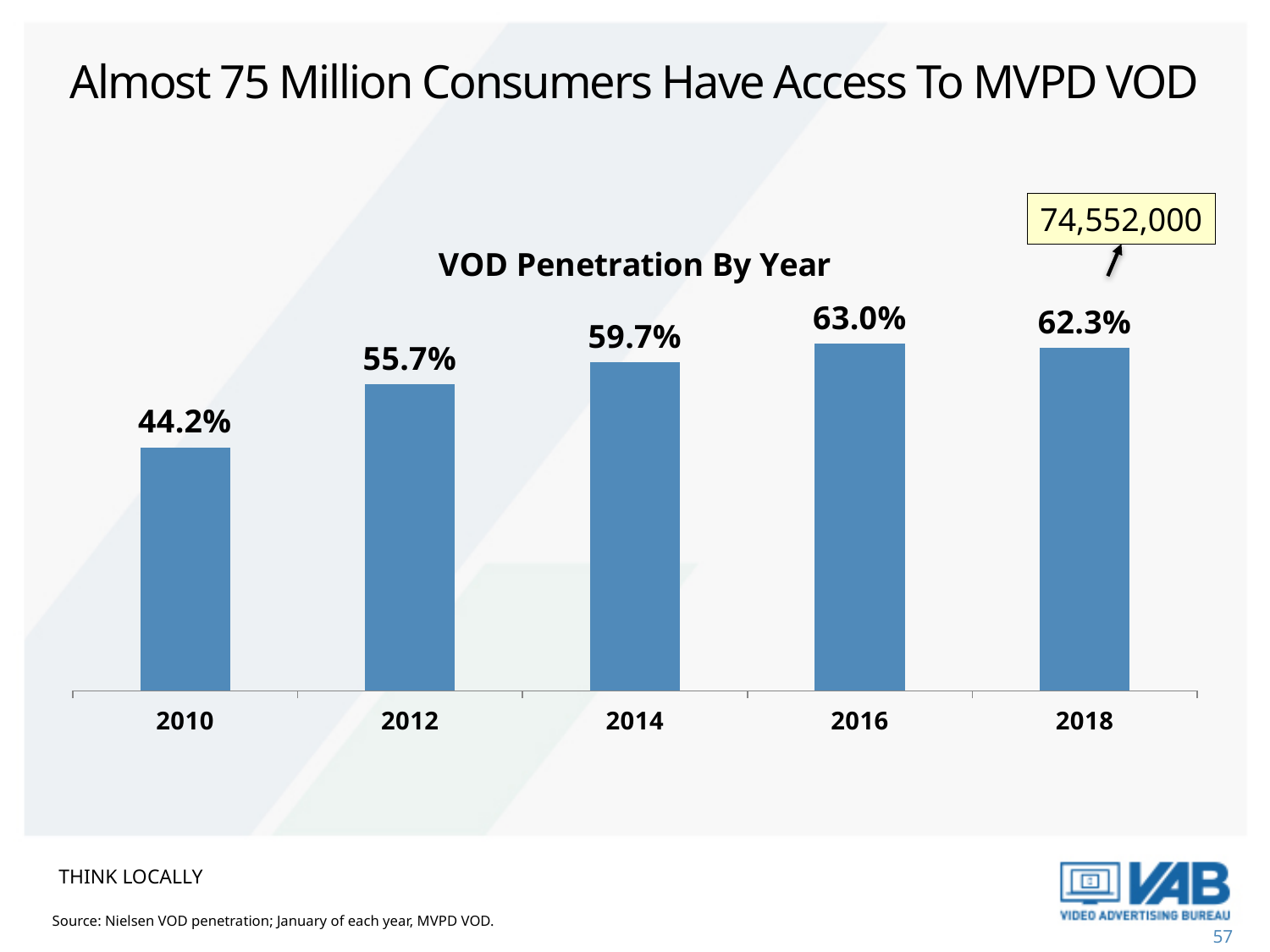
What kind of chart is shown on the slide? Bar chart What is the VOD penetration value for 2018? 62.3% Which is larger, the VOD penetration in 2012 or in 2014? 2014 What is the difference in VOD penetration between 2016 and 2018? 0.7% What is the difference in VOD penetration between 2012 and 2010? 11.5% What is the VOD penetration value for 2010? 44.2% What is the title of the chart? VOD Penetration By Year What is the VOD penetration value for 2014? 59.7% Does VOD penetration rise or fall from 2010 to 2016? Rise Which year has the lowest VOD penetration? 2010 Which year has the highest VOD penetration? 2016 How many years are shown on the x axis of the chart? 5